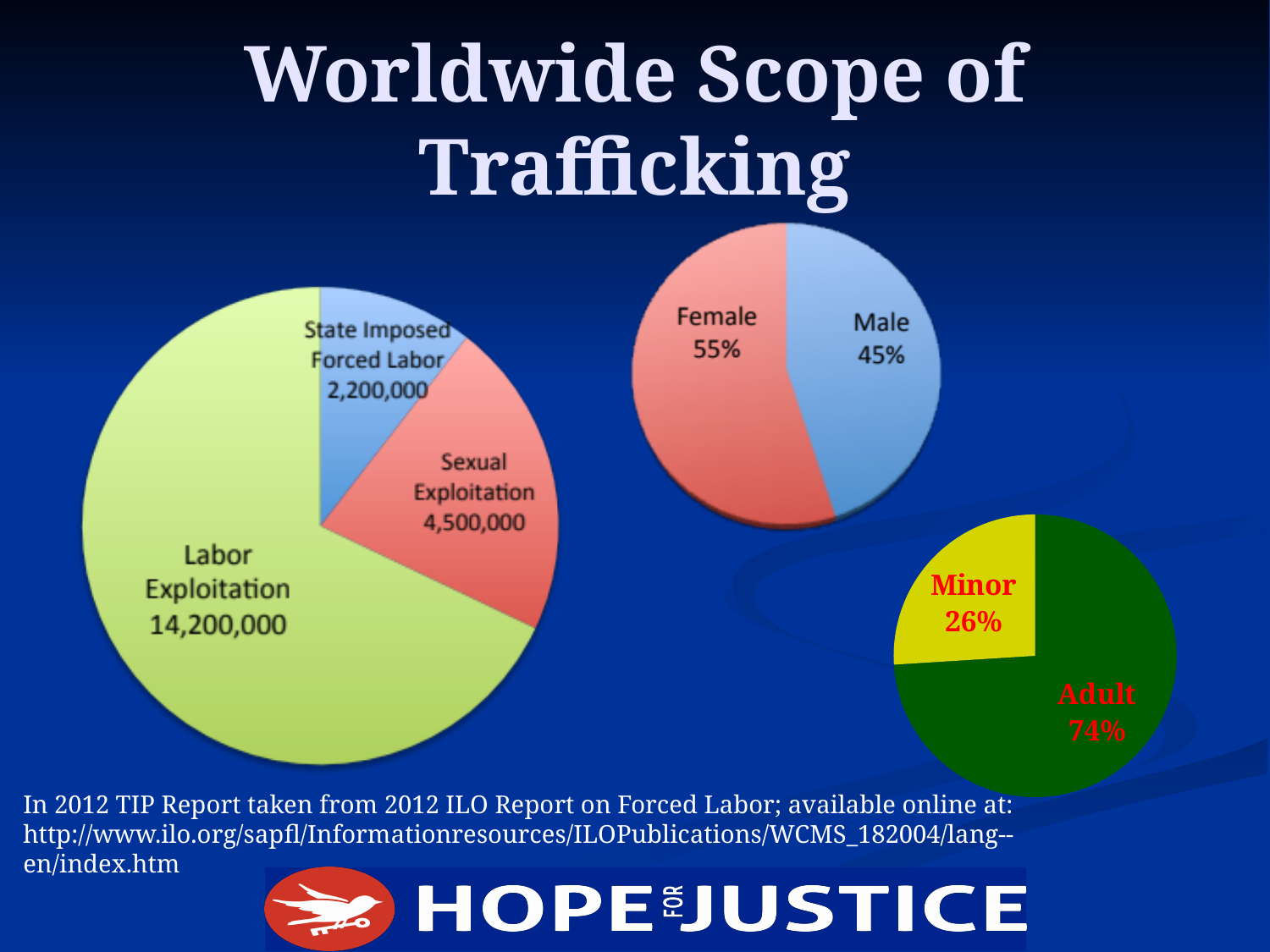
In the pie chart at the top right, what percentage is Female? 55% In the large pie chart on the left, what is the value for Sexual Exploitation? 4,500,000 In the large pie chart on the left, what is the difference between Sexual Exploitation and State Imposed Forced Labor? 2,300,000 In the large pie chart on the left, how many categories are shown? 3 What type of charts are shown on the slide? Pie charts In the large pie chart on the left, which category has the largest value? Labor Exploitation In the large pie chart on the left, what is the value for Labor Exploitation? 14,200,000 In the large pie chart on the left, what is the value for State Imposed Forced Labor? 2,200,000 In the pie chart at the bottom right, what is the difference between the Adult and Minor shares? 48% In the pie chart at the top right, which is larger, Female or Male? Female In the pie chart at the bottom right, what percentage is Minor? 26% In the large pie chart on the left, which category has the smallest value? State Imposed Forced Labor